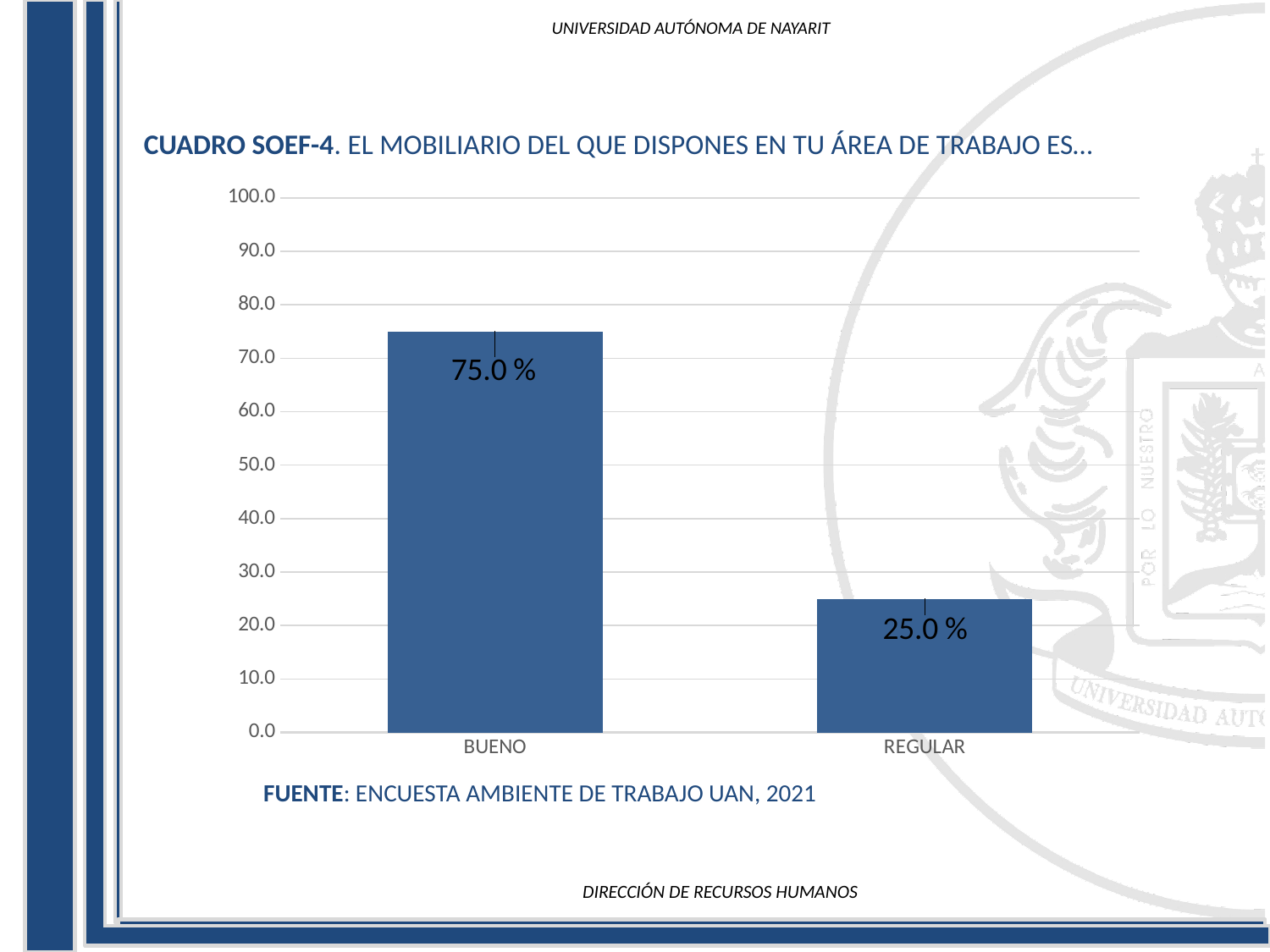
What is the value for BUENO? 75.0 % What is the value for REGULAR? 25.0 % Which is larger, the value for BUENO or the value for REGULAR? BUENO Which category has the highest value? BUENO What is the difference between the values for BUENO and REGULAR? 50.0 % How many categories are shown on the x axis? 2 What is the total of the two values shown in the chart? 100.0 % Which category has the lowest value? REGULAR What source is cited below the chart? ENCUESTA AMBIENTE DE TRABAJO UAN, 2021 Is the value for BUENO greater or less than 70.0? greater What kind of chart is shown on the slide? bar chart Is the value for REGULAR greater or less than 30.0? less